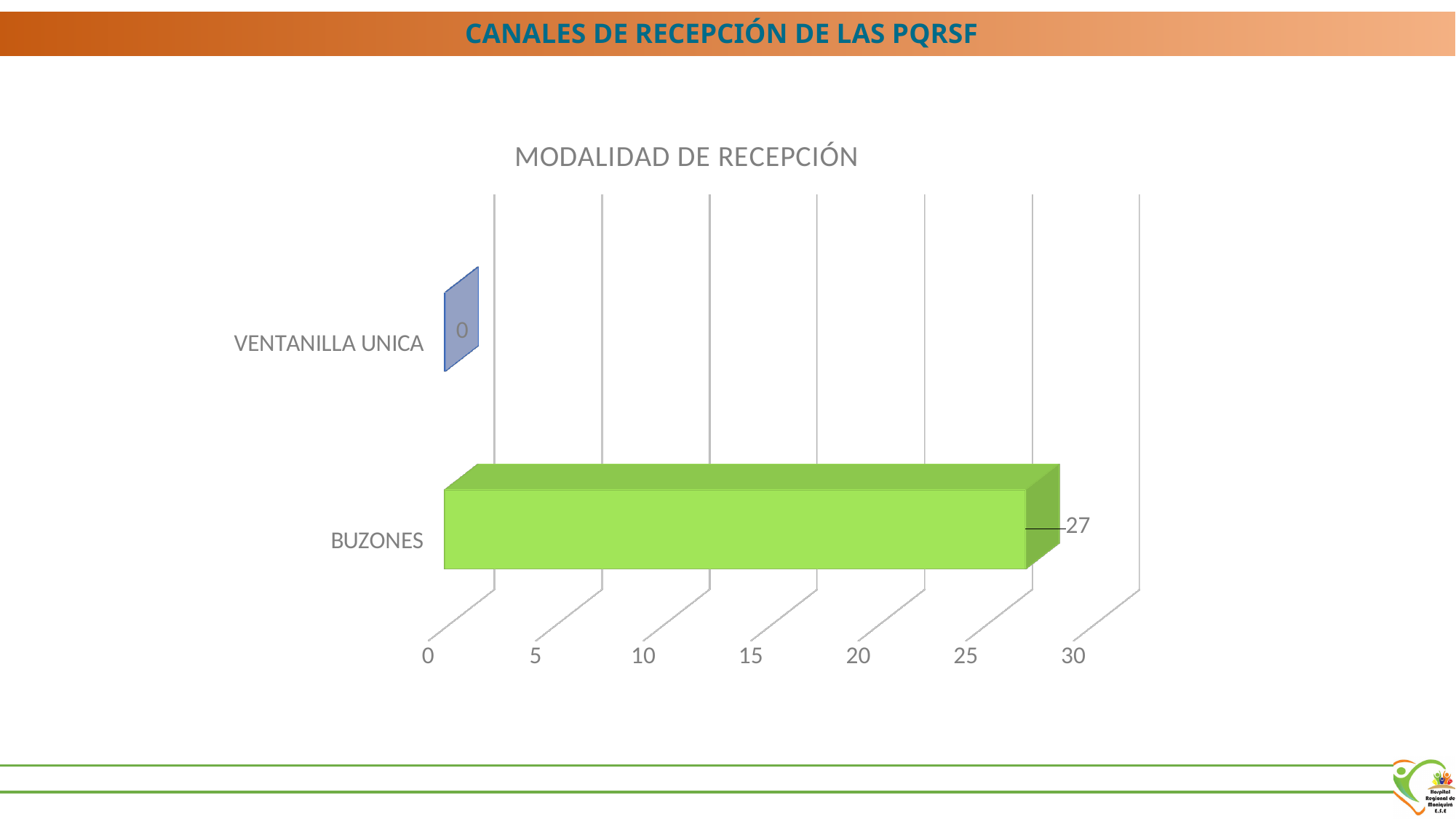
What colour is the bar for BUZONES? green What is the title of the chart? MODALIDAD DE RECEPCIÓN Which category has the lowest value? VENTANILLA UNICA What is the difference between the values for BUZONES and VENTANILLA UNICA? 27 What is the value for VENTANILLA UNICA? 0 How many categories are shown in the chart? 2 Which is larger, the value for BUZONES or the value for VENTANILLA UNICA? BUZONES Which category has the highest value? BUZONES What kind of chart is shown on the slide? bar chart What is the value for BUZONES? 27 Is the value for BUZONES greater or less than 25? greater What is the maximum value shown on the horizontal axis? 30